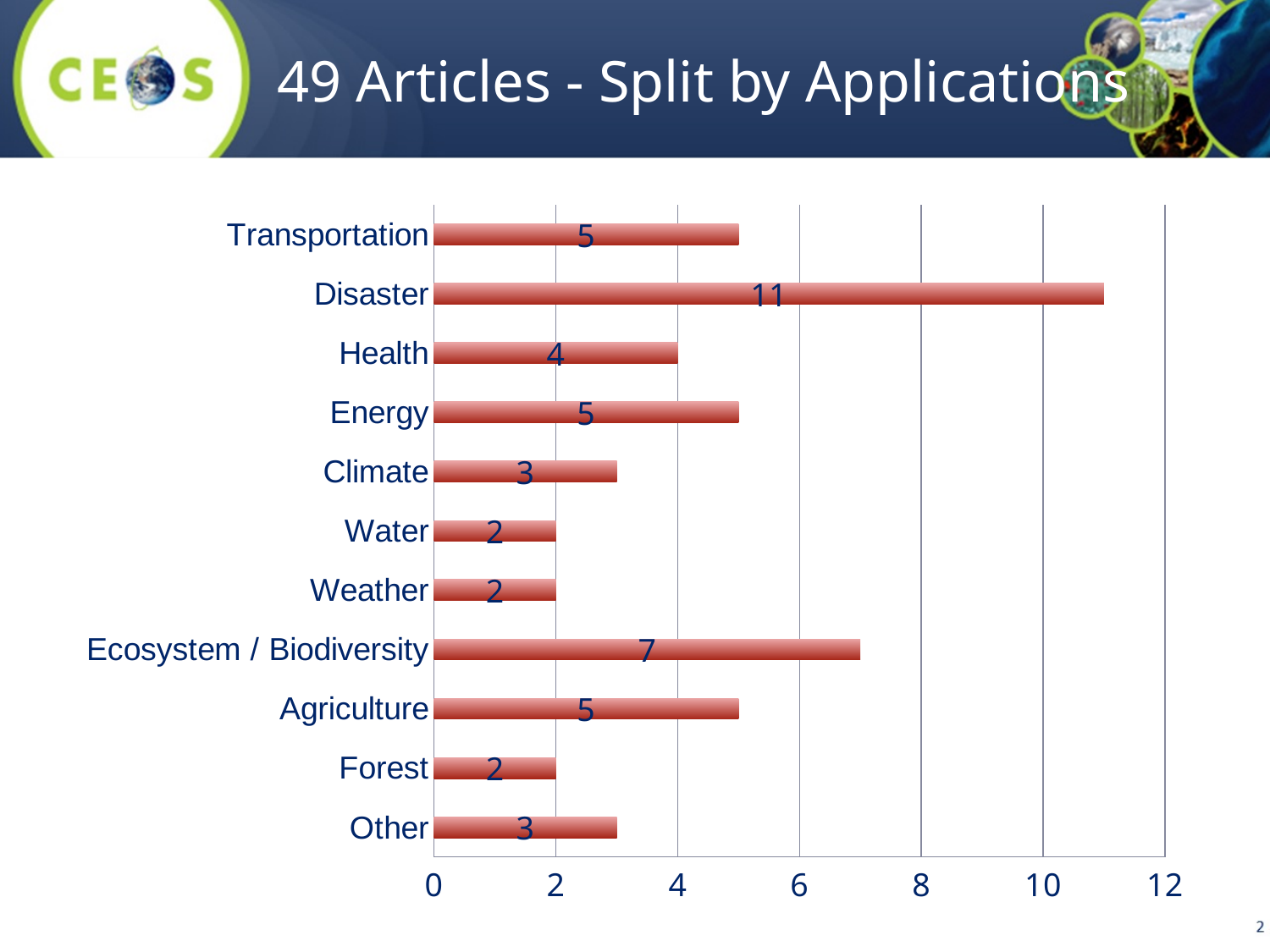
What is the value for Ecosystem / Biodiversity? 7 How many categories are shown in the chart? 11 Is the value for Disaster greater or less than 10? greater Which is larger, the value for Climate or the value for Health? Health What kind of chart is shown on the slide? Bar chart What is the difference between the values for Transportation and Water? 3 What is the difference between the values for Disaster and Ecosystem / Biodiversity? 4 What is the title of the slide? 49 Articles - Split by Applications What is the value for Other? 3 Which category has the highest value? Disaster What is the value for Disaster? 11 What is the value for Health? 4